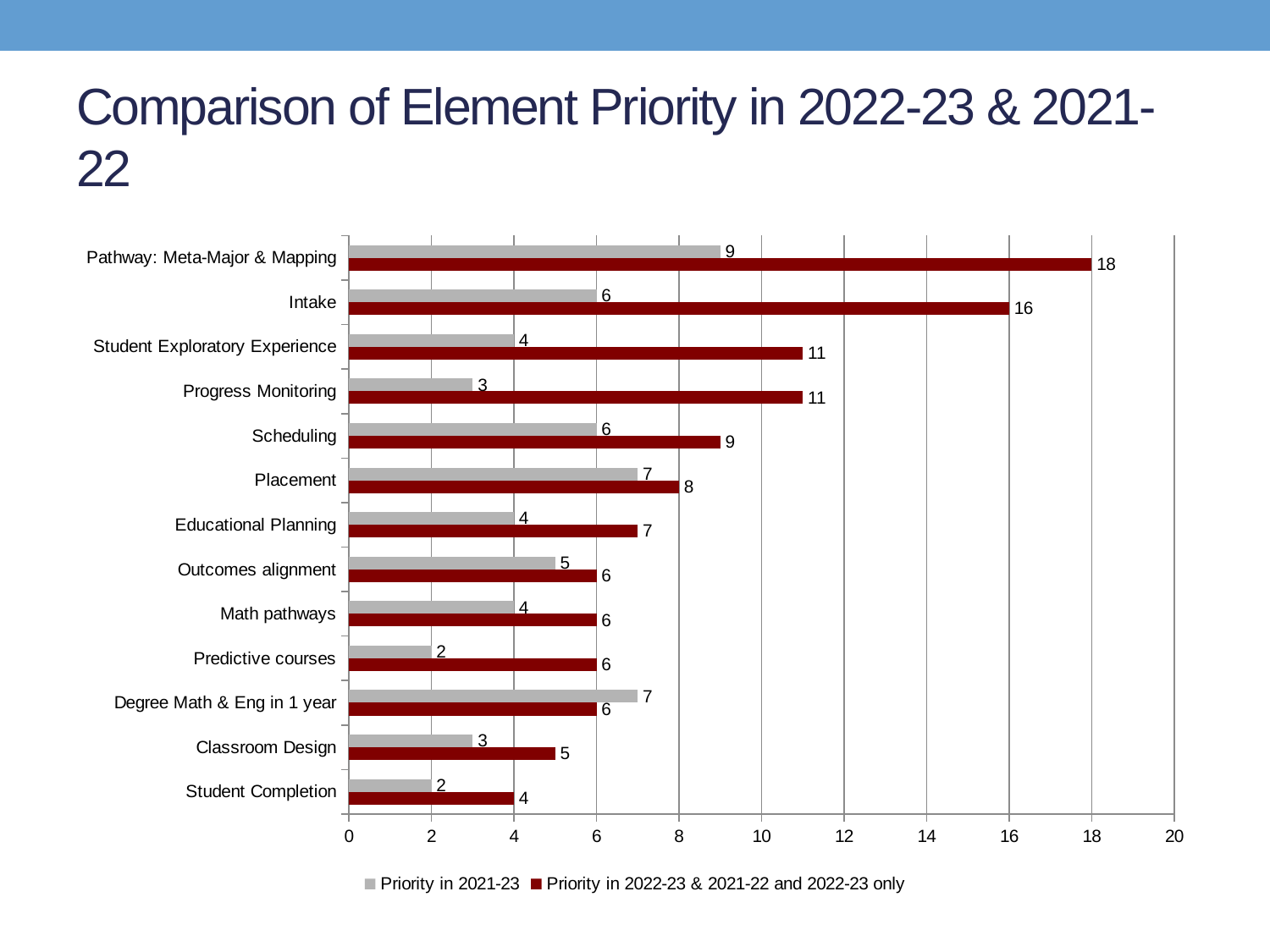
How many series does the legend list? 2 Is the value for Intake in the 'Priority in 2022-23 & 2021-22 and 2022-23 only' series greater or less than 14? greater For Degree Math & Eng in 1 year, which series has the larger value? Priority in 2021-23 What kind of chart is shown on the slide? Bar chart How many categories are shown on the chart? 13 What is the title of the chart? Comparison of Element Priority in 2022-23 & 2021-22 Which category has the highest value in the 'Priority in 2022-23 & 2021-22 and 2022-23 only' series? Pathway: Meta-Major & Mapping Which category has the lowest value in the 'Priority in 2022-23 & 2021-22 and 2022-23 only' series? Student Completion What is the value for Predictive courses in the 'Priority in 2021-23' series? 2 What is the value for Scheduling in the 'Priority in 2021-23' series? 6 What is the value for Intake in the 'Priority in 2022-23 & 2021-22 and 2022-23 only' series? 16 What is the difference between the two series values for Pathway: Meta-Major & Mapping? 9